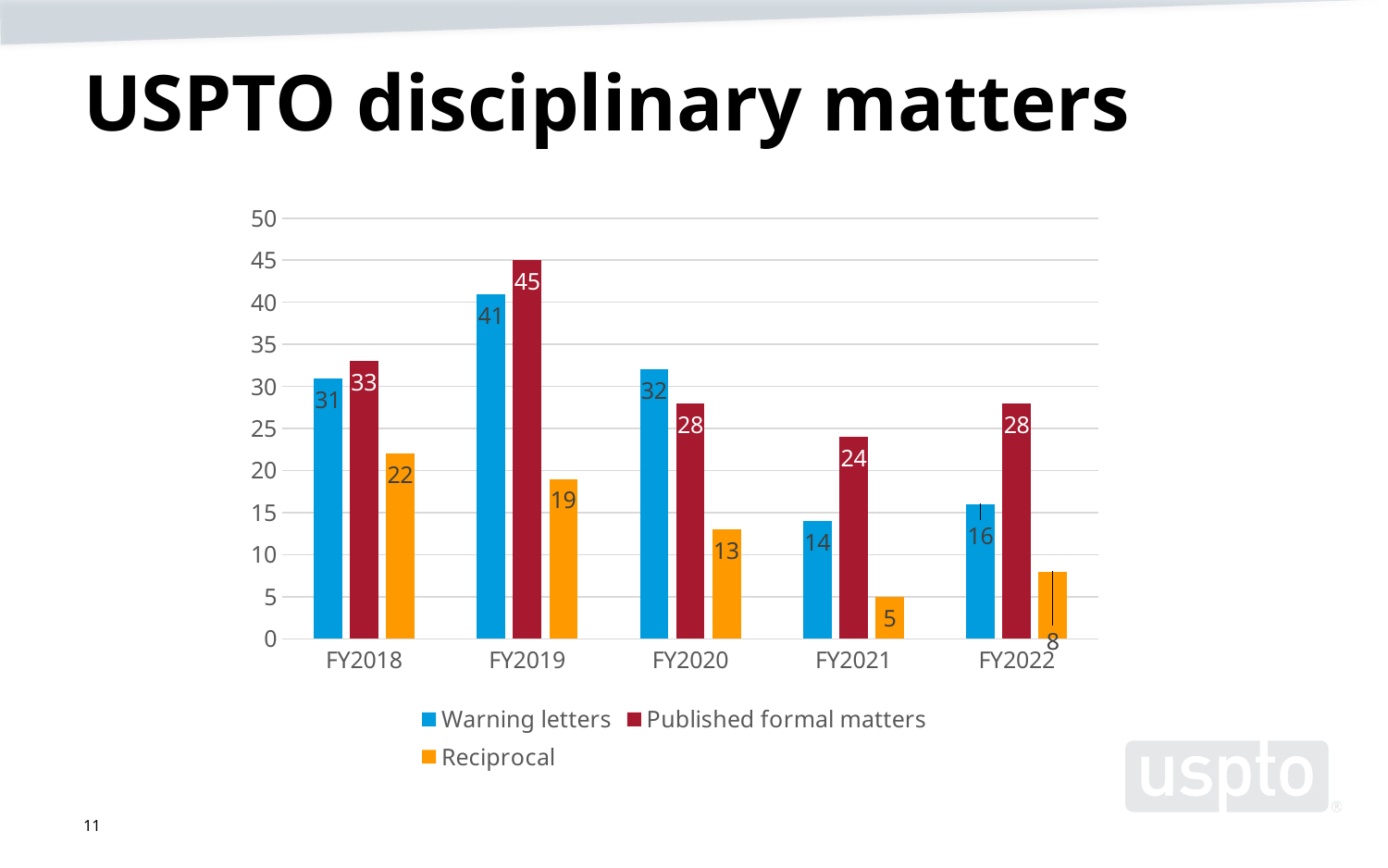
What is the value for Published formal matters in FY2021? 24 What is the value for Warning letters in FY2019? 41 How many fiscal years are shown on the x axis? 5 What is the difference between Published formal matters and Warning letters in FY2022? 12 How many series does the legend list? 3 What is the title of the slide containing the chart? USPTO disciplinary matters Which fiscal year has the lowest value for Reciprocal? FY2021 Is the value for Warning letters in FY2018 greater or less than 25? greater Which fiscal year has the highest value for Published formal matters? FY2019 What kind of chart is shown on the slide? Bar chart Which is larger in FY2020, Warning letters or Published formal matters? Warning letters What is the value for Reciprocal in FY2018? 22